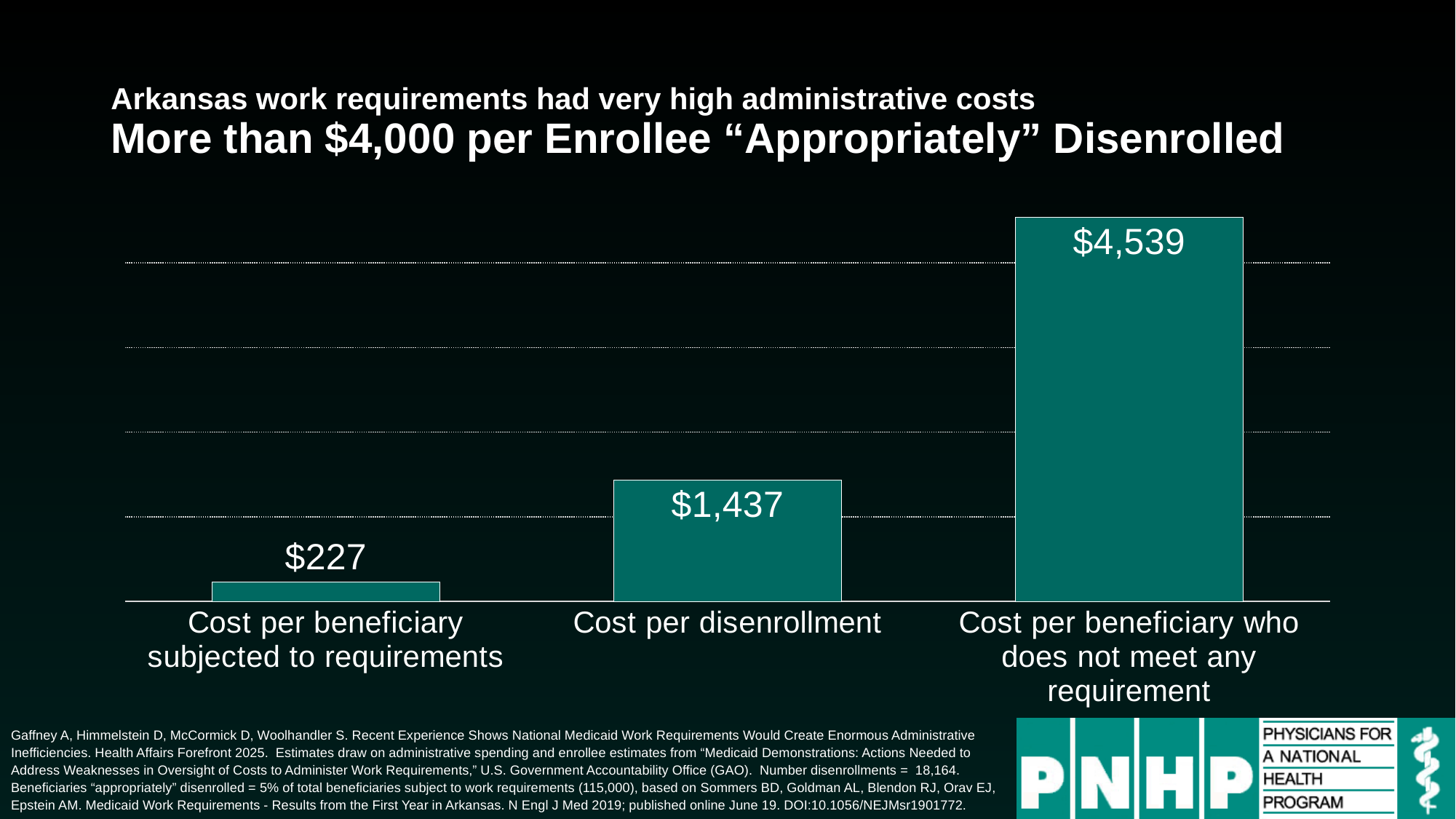
What is the difference between the cost per beneficiary who does not meet any requirement and the cost per disenrollment? $3,102 Do the values rise or fall from left to right across the categories? Rise What is the main title of the slide above the chart? More than $4,000 per Enrollee "Appropriately" Disenrolled What is the difference between the cost per disenrollment and the cost per beneficiary subjected to requirements? $1,210 What is the cost per disenrollment? $1,437 Which category has the highest value? Cost per beneficiary who does not meet any requirement How many categories are shown in the chart? 3 What is the cost per beneficiary subjected to requirements? $227 Which category has the lowest value? Cost per beneficiary subjected to requirements What kind of chart is shown on the slide? Bar chart Which is larger: the cost per disenrollment or the cost per beneficiary subjected to requirements? Cost per disenrollment What is the cost per beneficiary who does not meet any requirement? $4,539